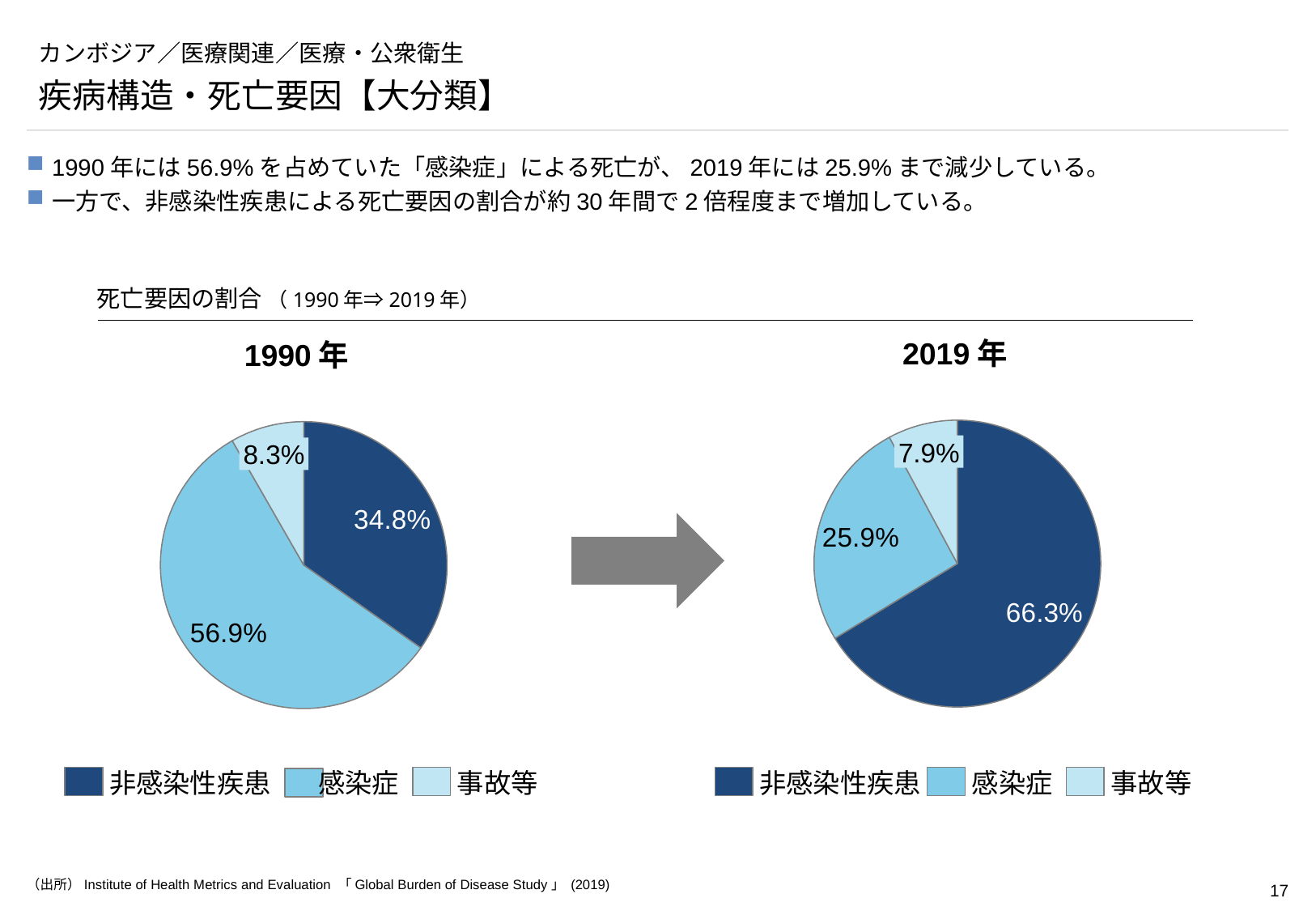
2019年の円グラフで、最も割合が小さい項目はどれですか？ 事故等 1990年の円グラフには、いくつの項目がありますか？ 3 2019年の円グラフで、「非感染性疾患」の割合は何%ですか？ 66.3% 1990年の円グラフで、「事故等」の割合は何%ですか？ 8.3% 2019年の円グラフで、「感染症」の割合は何%ですか？ 25.9% 2019年の円グラフで、「非感染性疾患」と「感染症」の割合の差は何ポイントですか？ 40.4ポイント 1990年の円グラフで、「感染症」の割合は何%ですか？ 56.9% 2019年の円グラフで、「非感染性疾患」は何色で示されていますか？ 濃い青 1990年の円グラフで、「非感染性疾患」と「感染症」ではどちらの割合が大きいですか？ 感染症 2019年の円グラフの凡例には、いくつの項目が示されていますか？ 3 1990年の円グラフで、最も割合が大きい項目はどれですか？ 感染症 このスライドの「死亡要因の割合」に使われているグラフの種類は何ですか？ 円グラフ